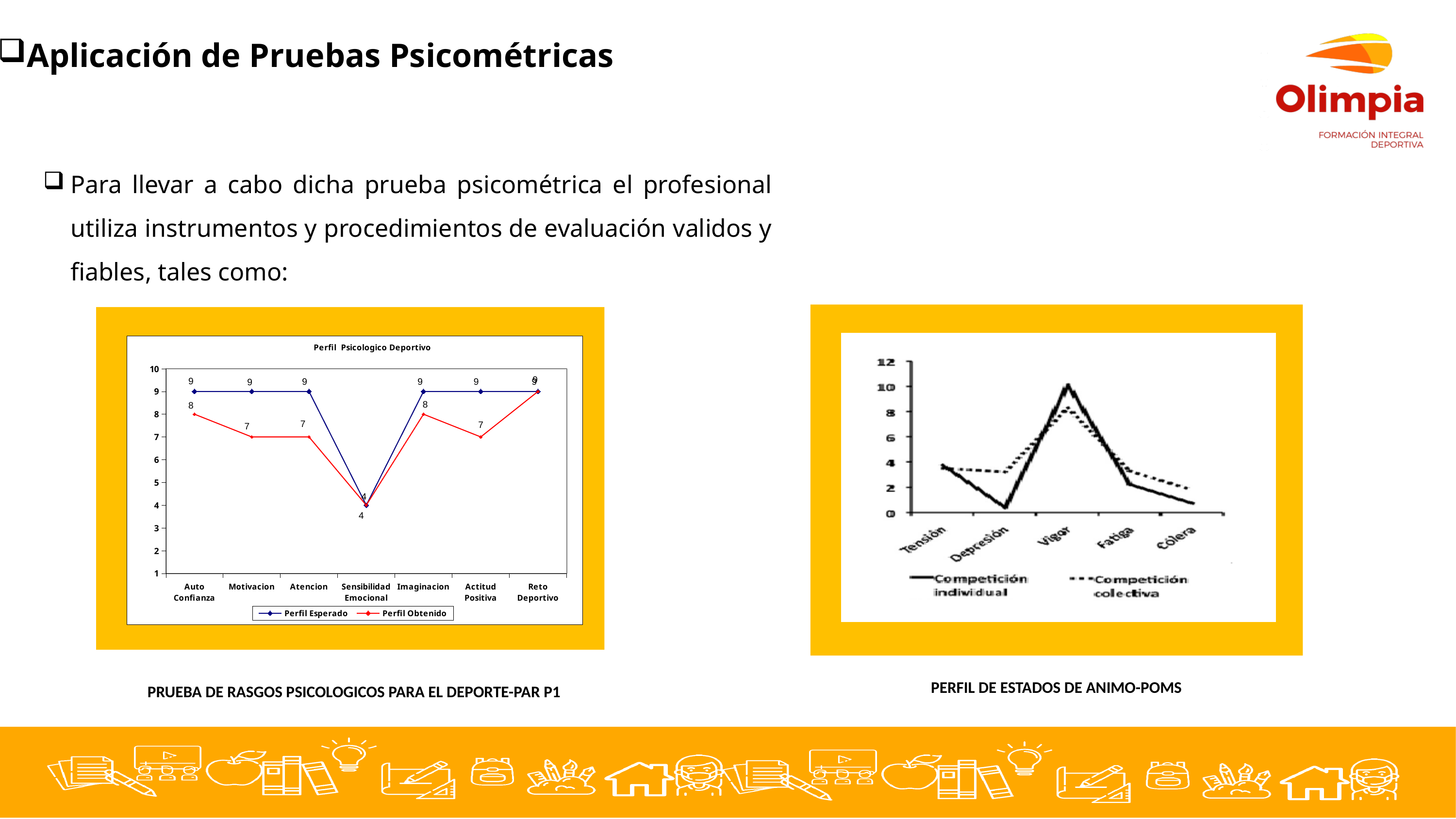
What kind of chart is the 'Perfil Psicologico Deportivo' chart? Line chart In the 'Perfil Psicologico Deportivo' chart, what is the Perfil Obtenido value for Motivacion? 7 In the 'Perfil Psicologico Deportivo' chart, which is larger for Atencion: Perfil Esperado or Perfil Obtenido? Perfil Esperado In the 'Perfil Psicologico Deportivo' chart, what is the Perfil Esperado value for Sensibilidad Emocional? 4 How many series does the legend of the 'Perfil Psicologico Deportivo' chart list? 2 How many categories are shown on the x axis of the 'Perfil Psicologico Deportivo' chart? 7 In the 'Perfil Psicologico Deportivo' chart, which category has the lowest Perfil Obtenido value? Sensibilidad Emocional In the chart on the right (PERFIL DE ESTADOS DE ANIMO-POMS), which category has the highest value for Competición individual? Vigor In the chart on the right (PERFIL DE ESTADOS DE ANIMO-POMS), is the Competición individual value for Depresión greater or less than 2? less In the 'Perfil Psicologico Deportivo' chart, what is the difference between Perfil Esperado and Perfil Obtenido for Actitud Positiva? 2 How many series does the legend of the chart on the right (PERFIL DE ESTADOS DE ANIMO-POMS) list? 2 In the 'Perfil Psicologico Deportivo' chart, what is the Perfil Obtenido value for Auto Confianza? 8